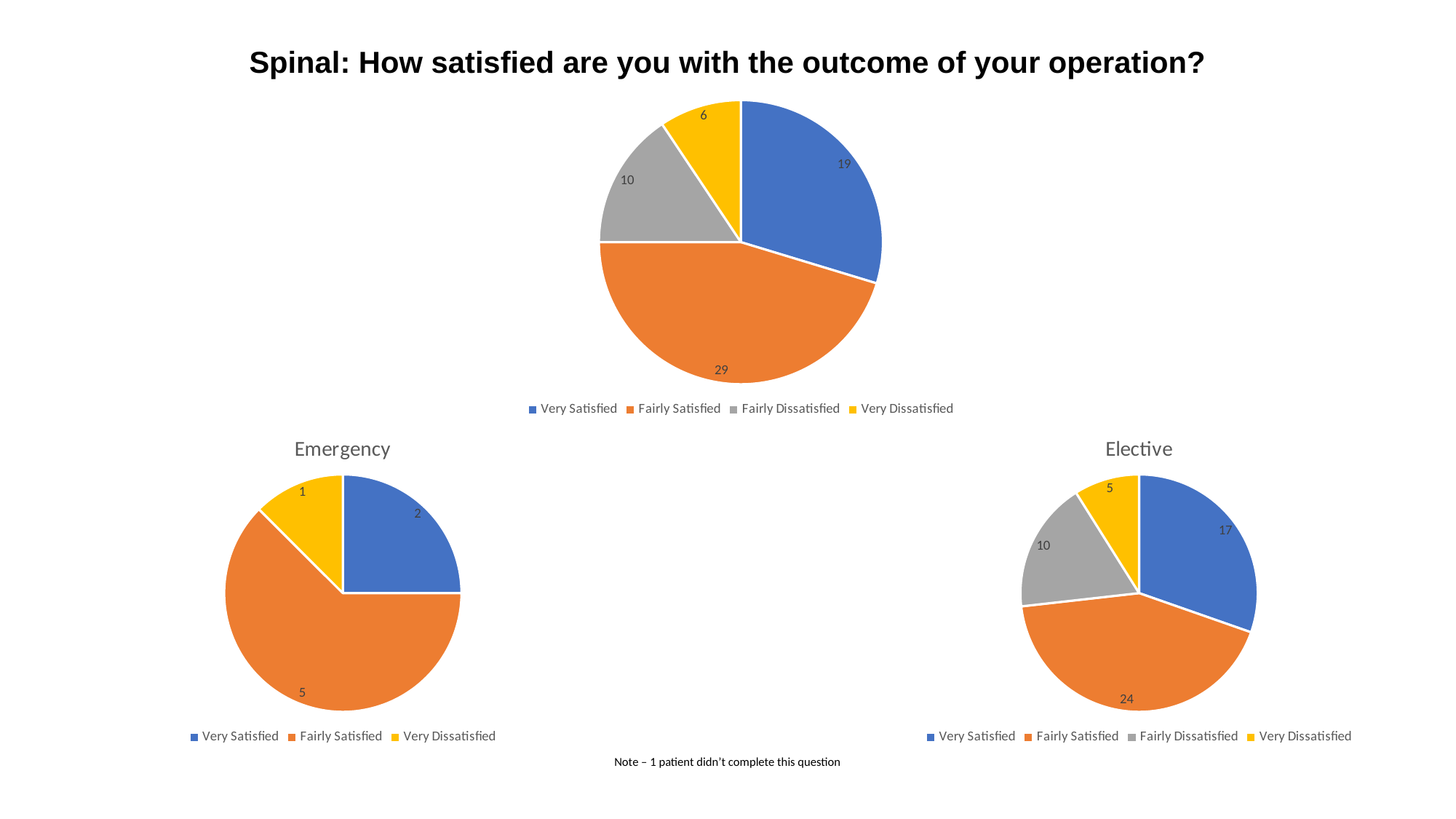
In the Emergency pie chart, what share of the pie is the Fairly Satisfied slice? 62.5% In the top pie chart, which category has the smallest slice? Very Dissatisfied In the Emergency pie chart, how many patients were Fairly Satisfied? 5 In the Elective pie chart, how many patients were Very Satisfied? 17 In the Elective pie chart, which is larger, Fairly Dissatisfied or Very Dissatisfied? Fairly Dissatisfied In the top pie chart, how many patients were Very Dissatisfied? 6 In the Emergency pie chart, how many categories does the legend list? 3 In the top pie chart, how many patients were Fairly Satisfied? 29 In the top pie chart, what is the difference between the Fairly Satisfied and Very Satisfied counts? 10 What type of chart is the Elective chart? Pie chart In the top pie chart, which category has the largest slice? Fairly Satisfied In the Elective pie chart, what is the total number of patients across all slices? 56